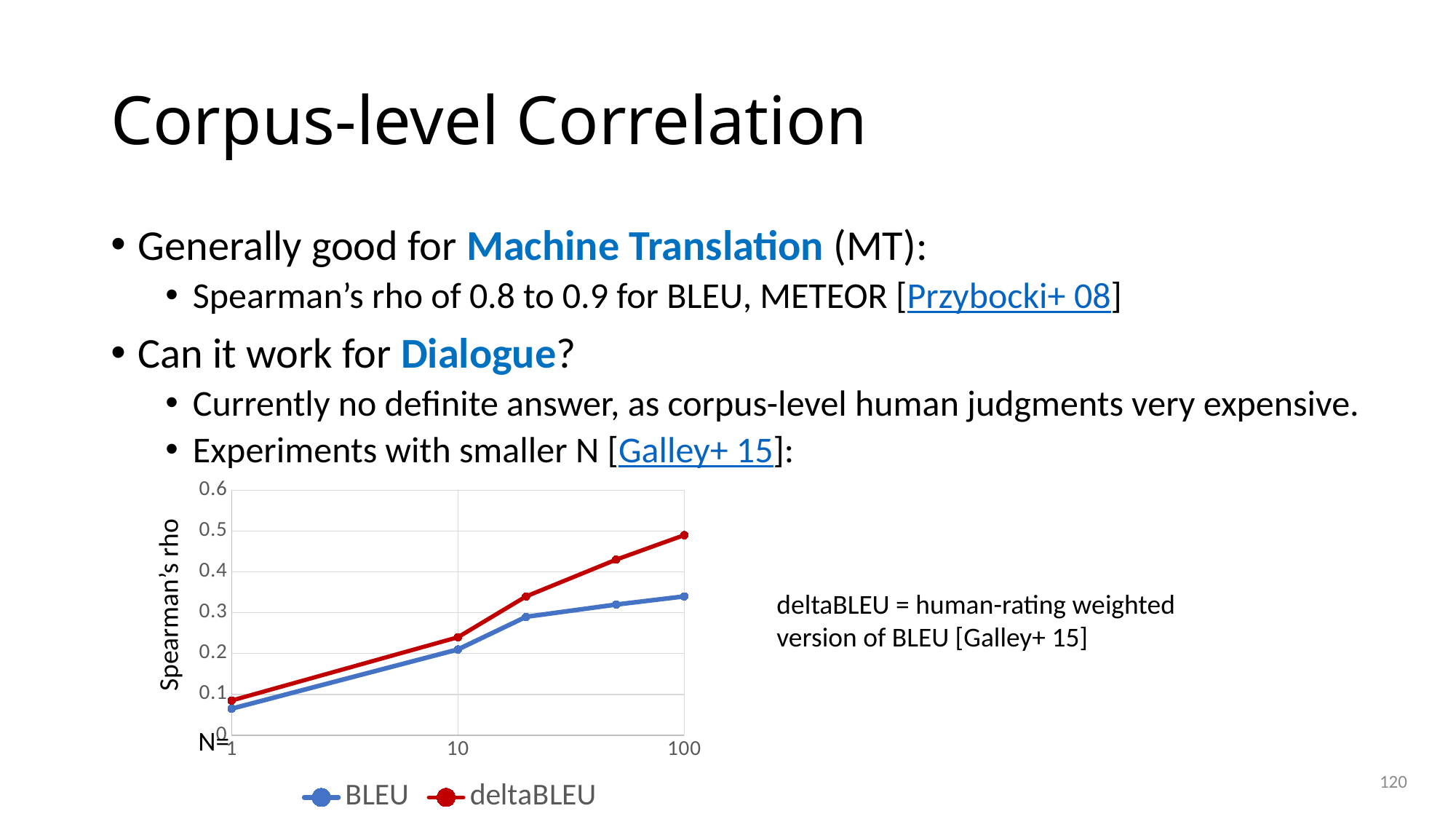
How many data points are plotted for the deltaBLEU series? 5 What kind of chart is shown on the slide? line chart Is the value for deltaBLEU at N=10 greater or less than 0.2? greater Do the values of the deltaBLEU series rise or fall as N increases along the x axis? rise Is the value for deltaBLEU at N=100 greater or less than 0.4? greater Do the values of the BLEU series rise or fall as N increases along the x axis? rise Which two series are listed in the chart legend? BLEU and deltaBLEU At N=100, which series has the higher Spearman's rho, BLEU or deltaBLEU? deltaBLEU How many series does the chart legend list? 2 Is the value for BLEU at N=1 greater or less than 0.1? less What is the label of the chart's y axis? Spearman's rho